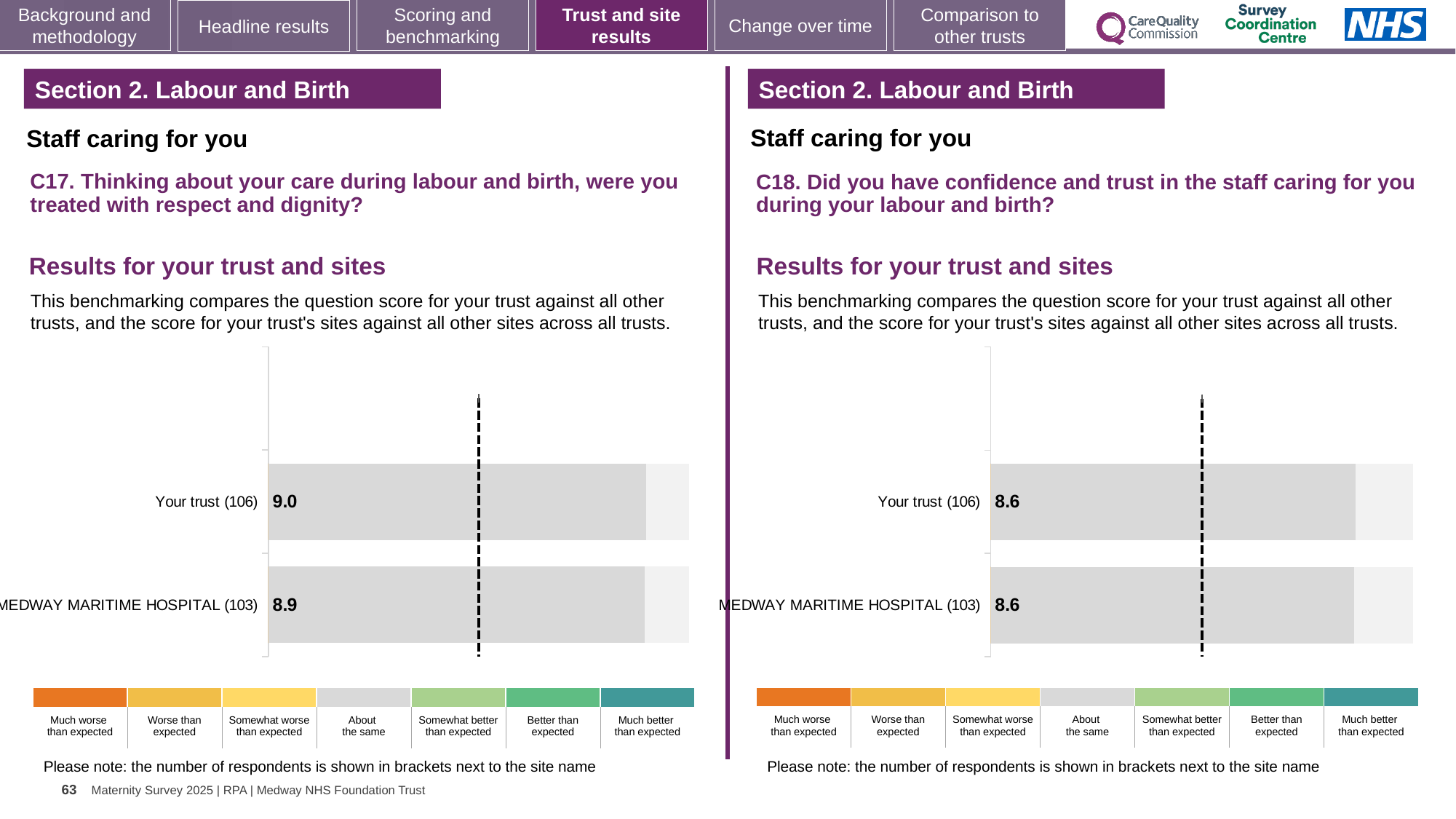
How many bars are plotted on the C18 chart (right)? 2 On the C17 chart (left), how many respondents are shown in brackets for Your trust? 106 On the C17 chart (left), what is the difference between the Your trust score and the Medway Maritime Hospital score? 0.1 What type of chart is used on the C17 chart (left)? Bar chart On the C18 chart (right), what is the score for Medway Maritime Hospital? 8.6 On the C17 chart (left), what is the score for Medway Maritime Hospital? 8.9 On the C17 chart (left), which has the higher score, Your trust or Medway Maritime Hospital? Your trust On the C18 chart (right), how many respondents are shown in brackets for Medway Maritime Hospital? 103 On the C18 chart (right), what is the score for Your trust? 8.6 How many bars are plotted on the C17 chart (left)? 2 On the C17 chart (left), what is the score for Your trust? 9.0 On the C18 chart (right), what is the difference between the Your trust score and the Medway Maritime Hospital score? 0